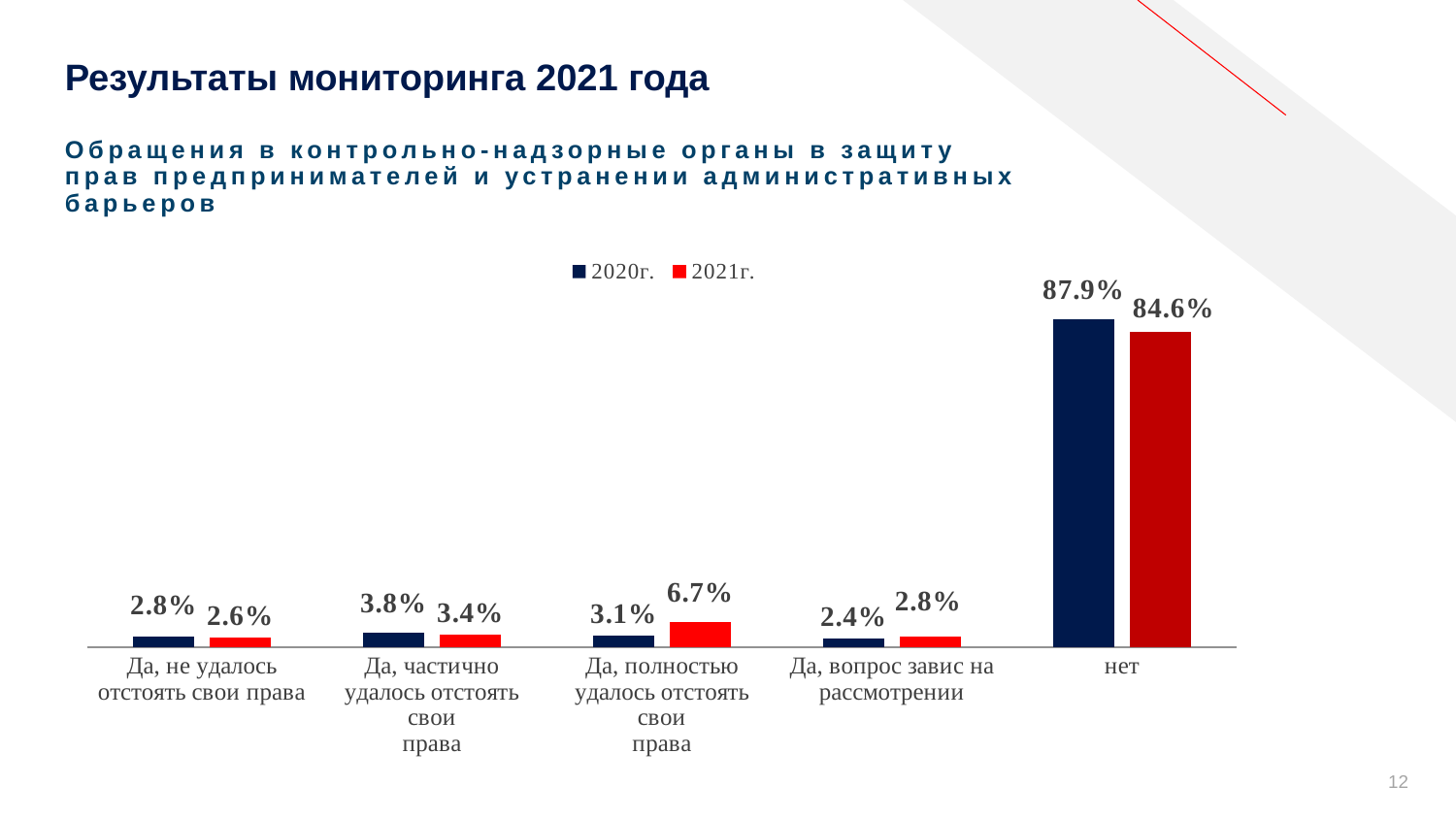
What is the difference between the 2020г. and 2021г. values for "нет"? 3.3% What kind of chart is shown on the slide? bar chart For "Да, частично удалось отстоять свои права", which year has the larger value, 2020г. or 2021г.? 2020г. What is the 2021г. value for "Да, вопрос завис на рассмотрении"? 2.8% How many categories are shown on the x axis? 5 Which category has the highest 2020г. value? нет How many series does the legend list? 2 Which category has the lowest 2020г. value? Да, вопрос завис на рассмотрении What is the 2020г. value for "Да, полностью удалось отстоять свои права"? 3.1% What is the difference between the 2021г. and 2020г. values for "Да, полностью удалось отстоять свои права"? 3.6% What is the 2021г. value for the category "нет"? 84.6% Which colour represents the 2021г. series? red